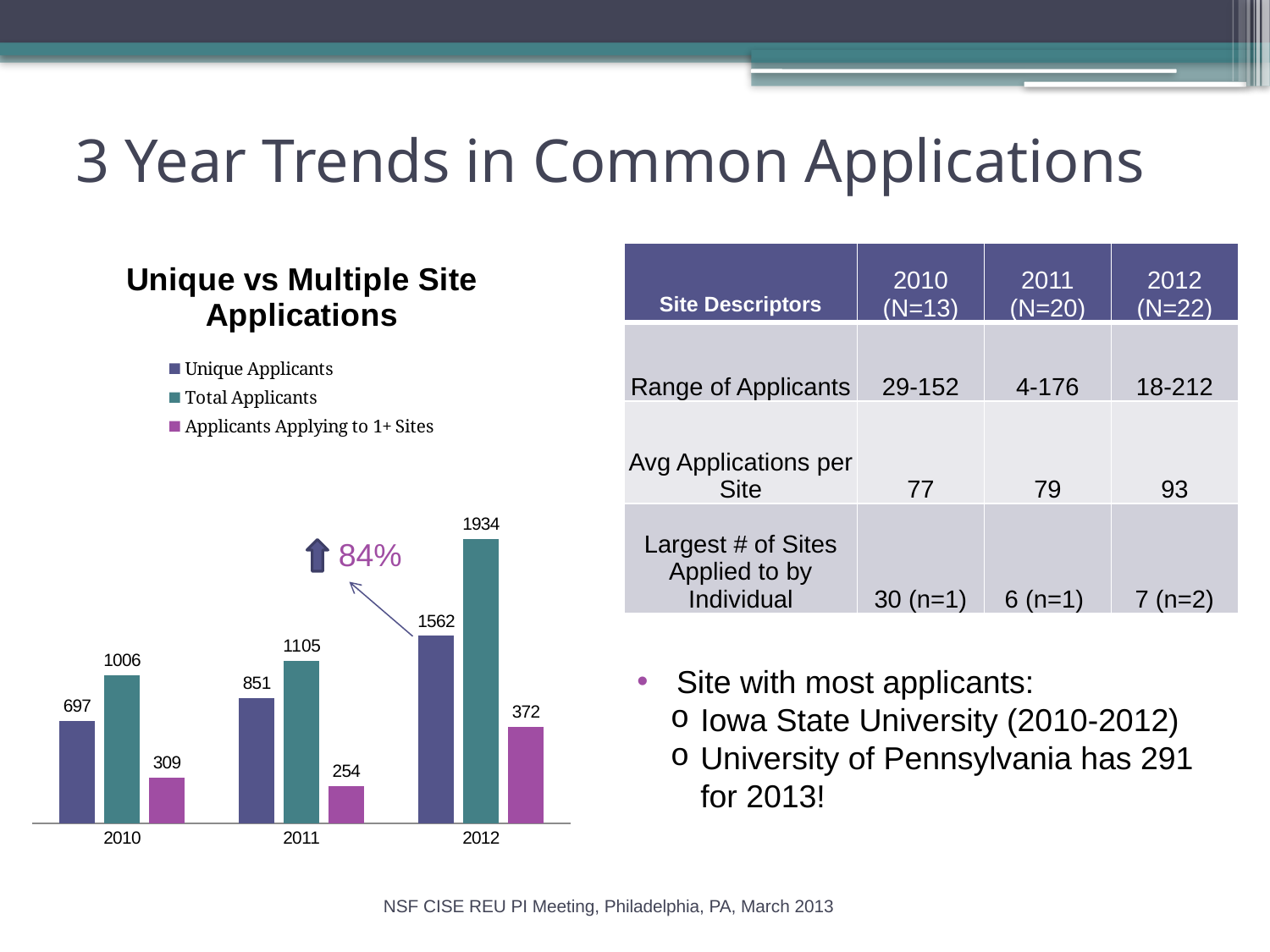
Do the Total Applicants values rise or fall from 2010 to 2012? Rise Which is larger, Unique Applicants in 2011 or Unique Applicants in 2010? Unique Applicants in 2011 What kind of chart is shown on the slide? Bar chart What is the value for Unique Applicants in 2010? 697 How many series does the chart legend list? 3 What is the title of the chart? Unique vs Multiple Site Applications Which year has the lowest value for Applicants Applying to 1+ Sites? 2011 What is the value for Applicants Applying to 1+ Sites in 2011? 254 What is the value for Total Applicants in 2012? 1934 Which year has the highest value for Total Applicants? 2012 How many years are shown on the x axis of the chart? 3